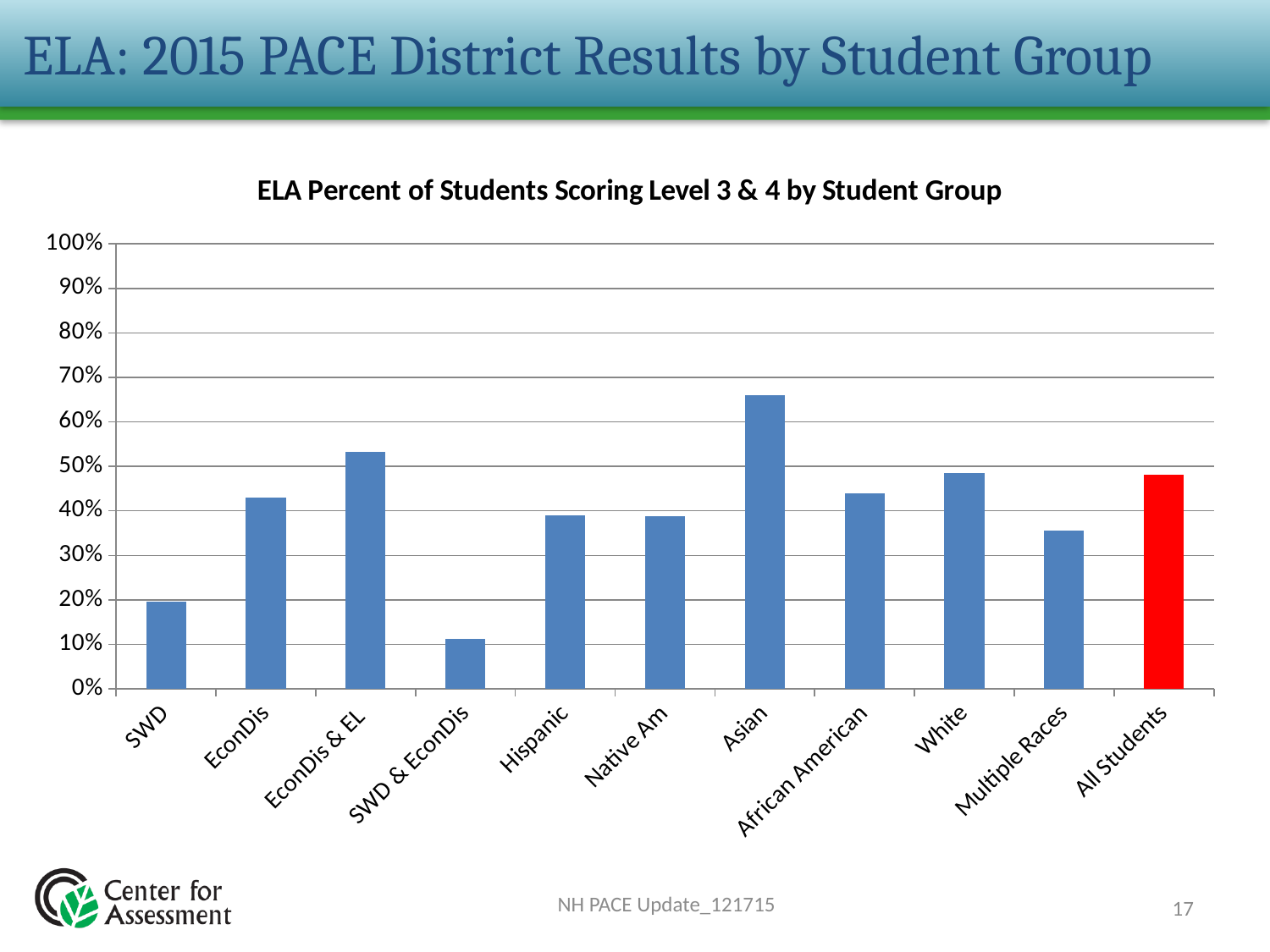
What kind of chart is shown on the slide? Bar chart Is the value for EconDis & EL greater or less than 50%? greater Which student group has the lowest percent of students scoring Level 3 & 4? SWD & EconDis How many student groups are plotted on the chart? 11 What is the title of the chart? ELA Percent of Students Scoring Level 3 & 4 by Student Group Which is larger, the value for EconDis or the value for SWD? EconDis Is the value for Asian greater or less than 60%? greater Which is larger, the value for White or the value for Multiple Races? White Is the value for Multiple Races greater or less than 40%? less Which student group has the highest percent of students scoring Level 3 & 4? Asian Which bar is coloured red instead of blue? All Students